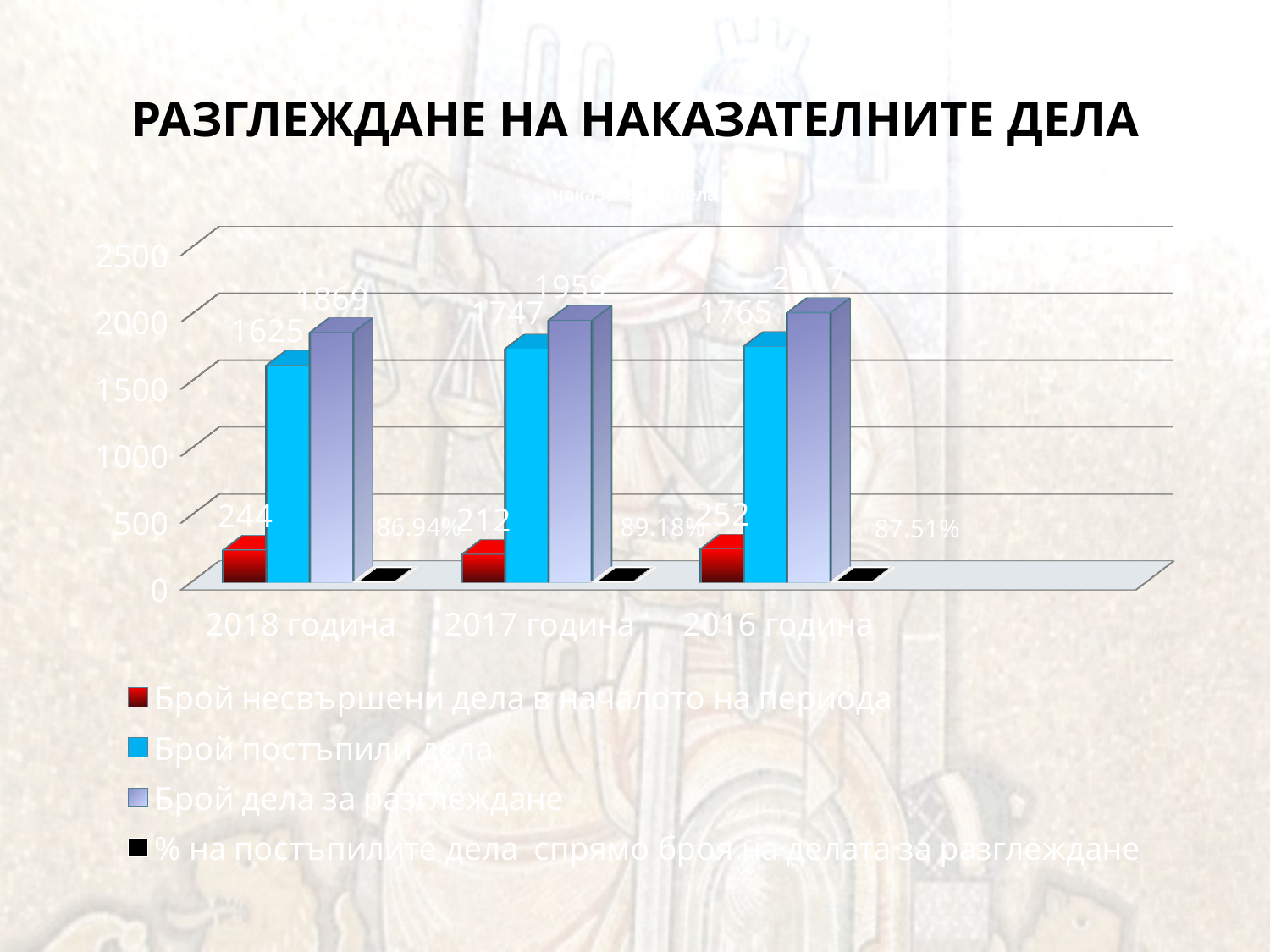
Which is larger: 'Брой несвършени дела в началото на периода' for 2018 година or for 2017 година? 2018 година What type of chart is shown on the slide? bar chart What is the value of 'Брой несвършени дела в началото на периода' for 2016 година? 252 How many year categories are shown on the x axis? 3 What is the value of 'Брой постъпили дела' for 2018 година? 1625 Which year has the lowest value for 'Брой несвършени дела в началото на периода'? 2017 година How many series does the legend list? 4 What is the difference between 'Брой дела за разглеждане' and 'Брой постъпили дела' for 2018 година? 244 Is the value of 'Брой постъпили дела' for 2017 година greater or less than 1500? greater What is the value of '% на постъпилите дела спрямо броя на делата за разглеждане' for 2017 година? 89.18% Which year has the highest value for 'Брой постъпили дела'? 2016 година What is the value of 'Брой дела за разглеждане' for 2017 година? 1959